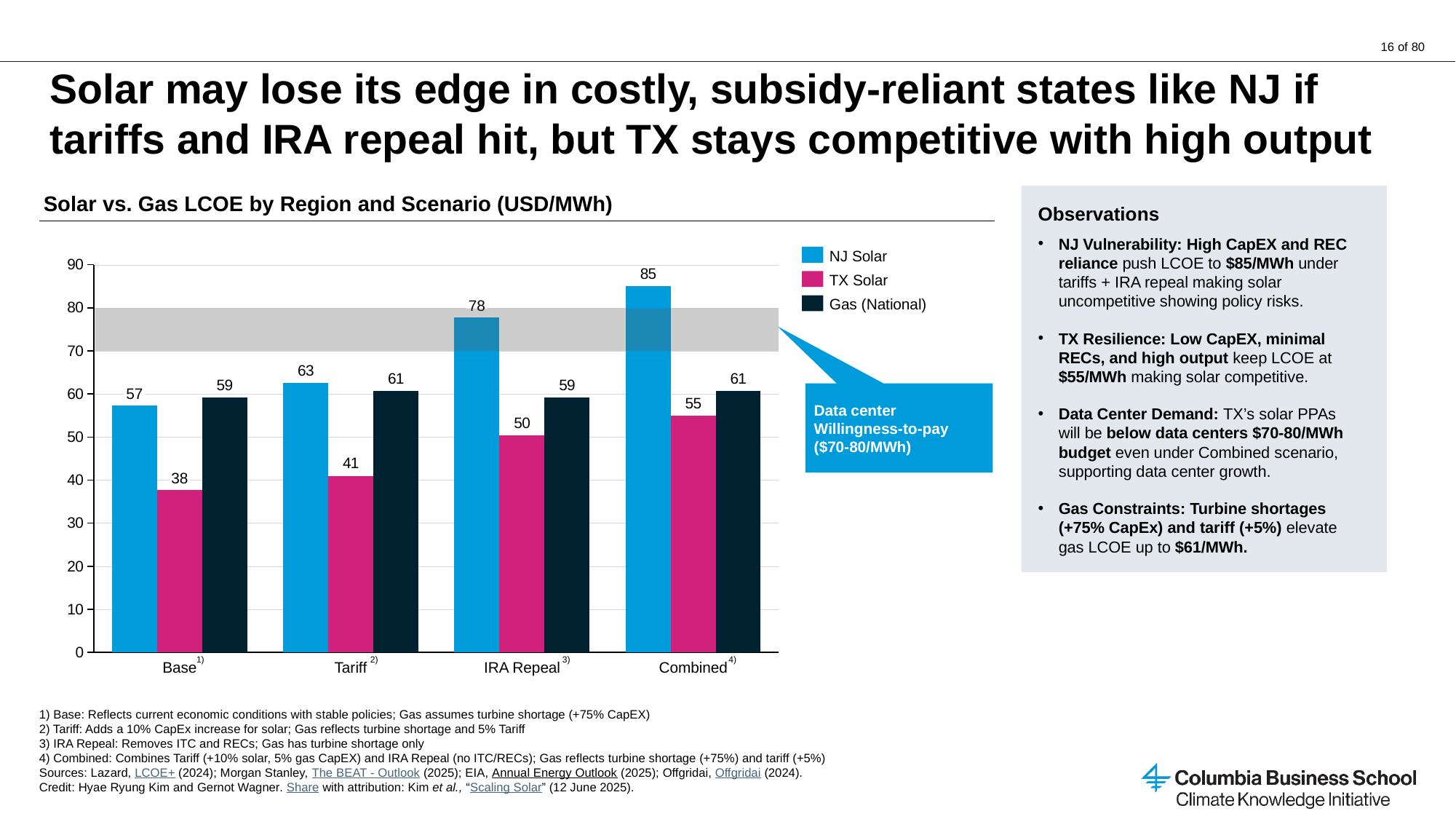
How many scenarios are shown on the x axis? 4 What is the TX Solar LCOE value in the Base scenario? 38 What is the Gas (National) LCOE value in the Tariff scenario? 61 Is the NJ Solar value in the Tariff scenario greater or less than 70? less What is the NJ Solar LCOE value in the Combined scenario? 85 What kind of chart is shown on the slide? Bar chart How many series does the legend list? 3 In which scenario is TX Solar LCOE lowest? Base What is the difference between NJ Solar and TX Solar LCOE in the IRA Repeal scenario? 28 In which scenario is NJ Solar LCOE highest? Combined What range does the shaded band labelled 'Data center Willingness-to-pay' cover? $70-80/MWh Which is larger in the Base scenario: NJ Solar or Gas (National)? Gas (National)